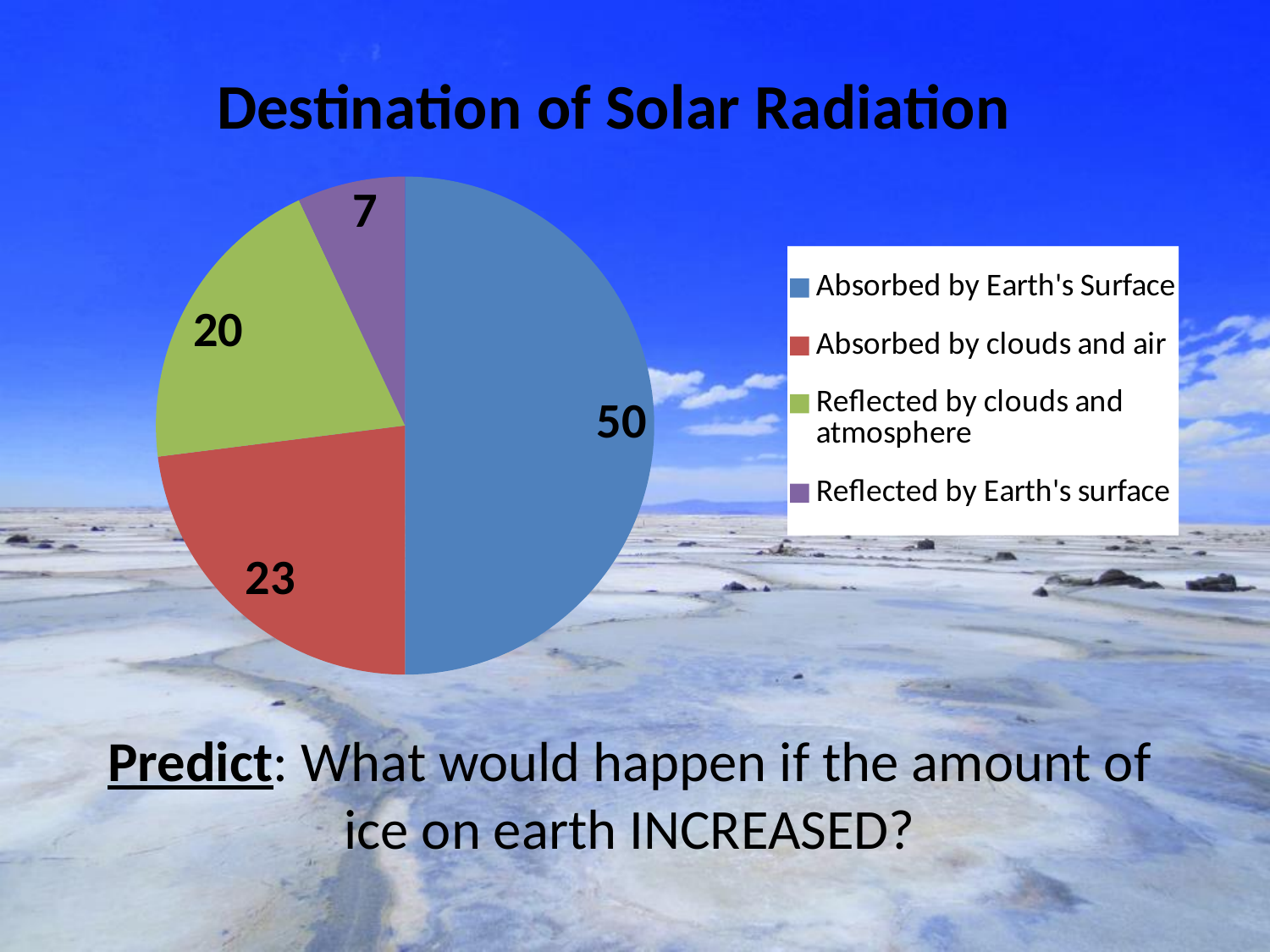
What kind of chart is shown on the slide? Pie chart What is the value for Absorbed by Earth's Surface? 50 What share of the total does Absorbed by Earth's Surface represent? 50% What is the title of the chart? Destination of Solar Radiation What is the difference between the values for Absorbed by Earth's Surface and Absorbed by clouds and air? 27 Which is larger: Absorbed by clouds and air or Reflected by clouds and atmosphere? Absorbed by clouds and air What is the value for Reflected by clouds and atmosphere? 20 What is the value for Reflected by Earth's surface? 7 How many categories does the pie chart show? 4 What is the value for Absorbed by clouds and air? 23 Which category has the smallest slice? Reflected by Earth's surface Which category has the largest slice? Absorbed by Earth's Surface